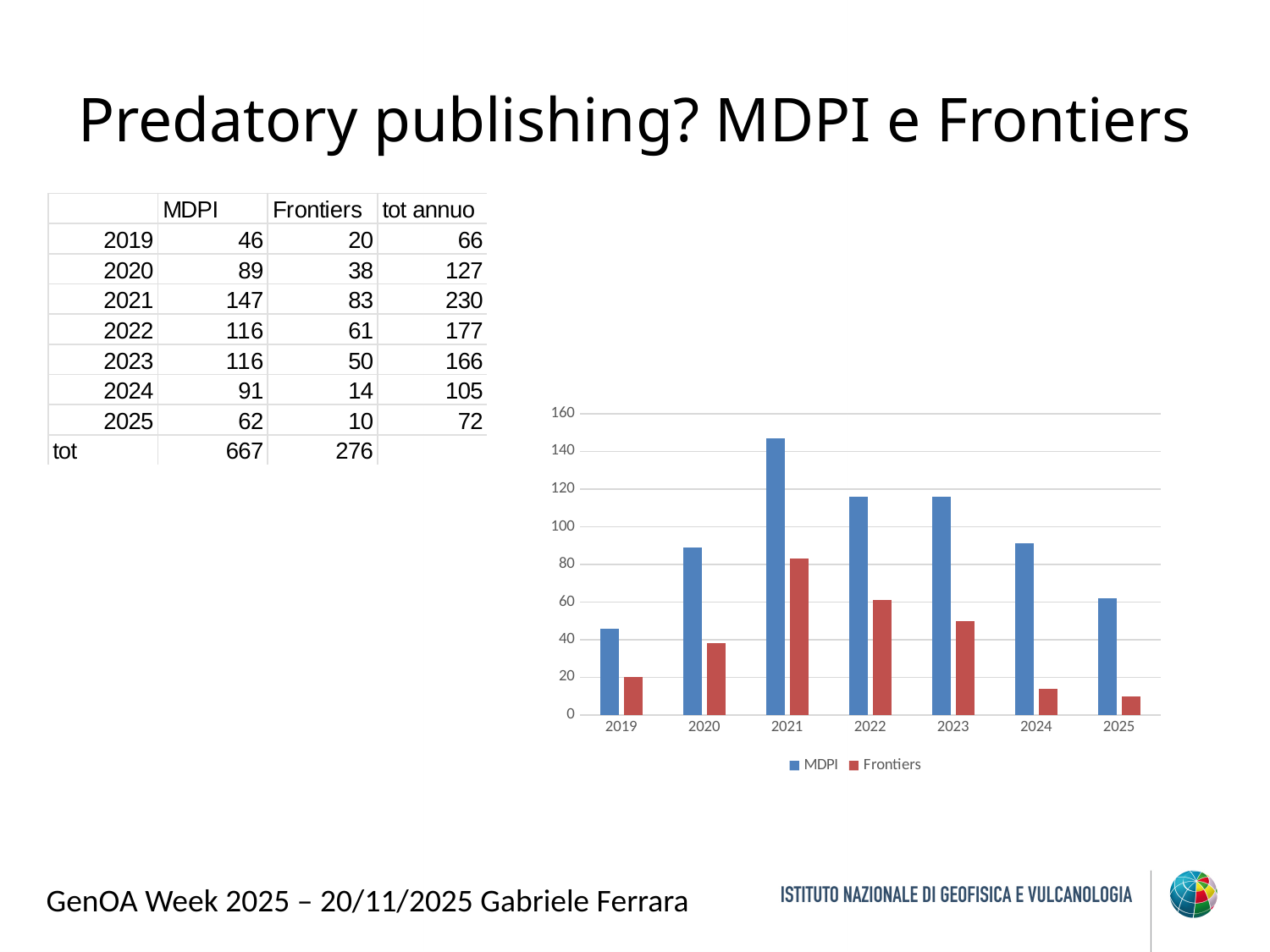
What is the Frontiers value for 2022? 61 What kind of chart is shown on the slide? bar chart Which is larger in 2020, the MDPI bar or the Frontiers bar? MDPI What is the MDPI value for 2021? 147 What is the difference between the MDPI and Frontiers values in 2021? 64 How many years are shown on the x axis of the chart? 7 How many series does the chart legend list? 2 Do the Frontiers bars rise or fall from 2021 to 2025? fall Is the Frontiers bar for 2024 greater or less than 20? less Is the MDPI bar for 2024 greater or less than 80? greater Which year has the highest MDPI bar? 2021 Which year has the lowest Frontiers bar? 2025